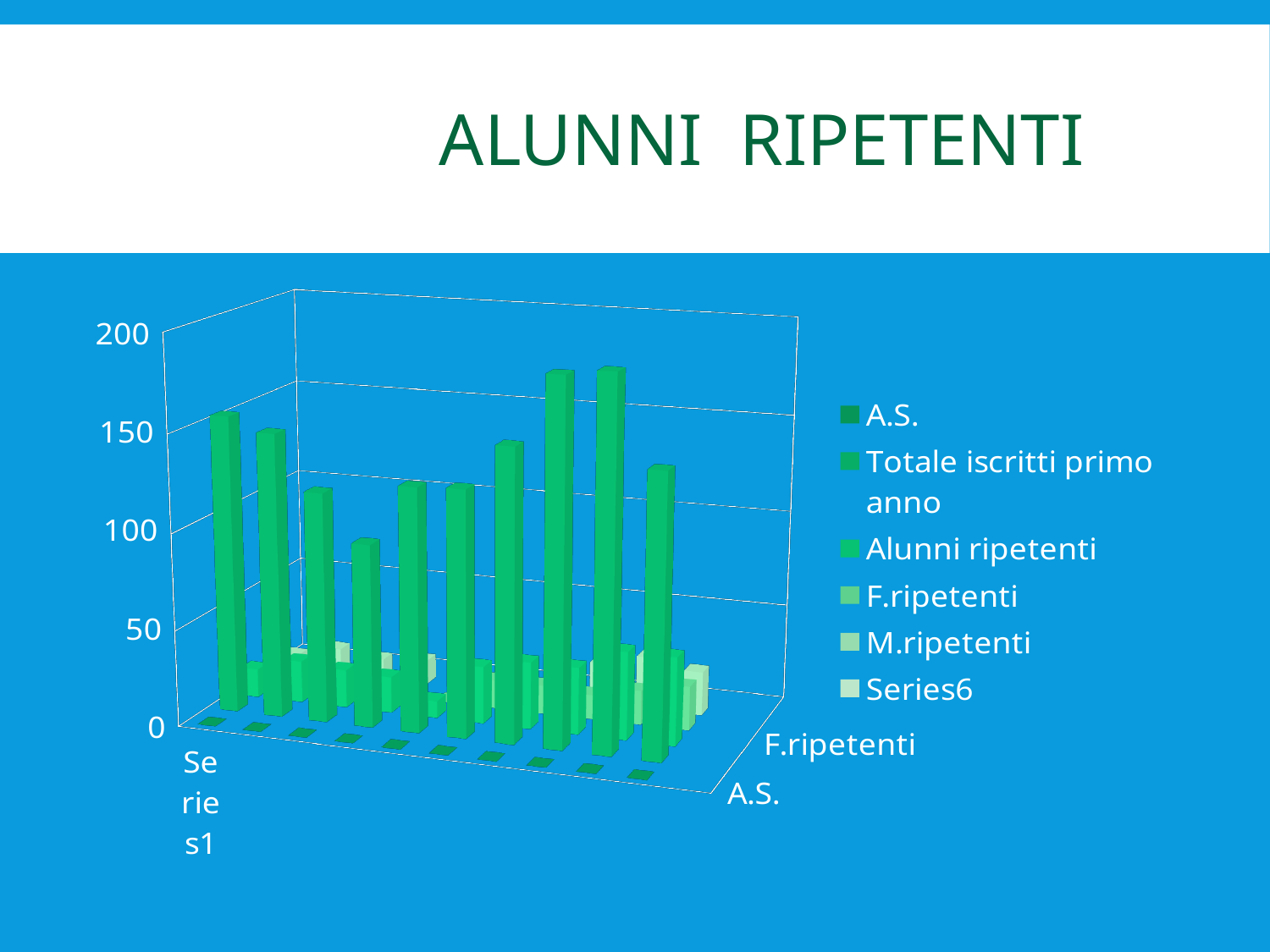
How many tall green bars are plotted in the chart? 10 Is the value of the first tall green bar on the left greater or less than 100? greater What is the title of the slide's chart? ALUNNI RIPETENTI What is the last entry listed in the chart legend? Series6 Is the value of the tallest bar in the chart greater or less than 150? greater What kind of chart is shown on the slide? bar chart How many series does the legend list? 6